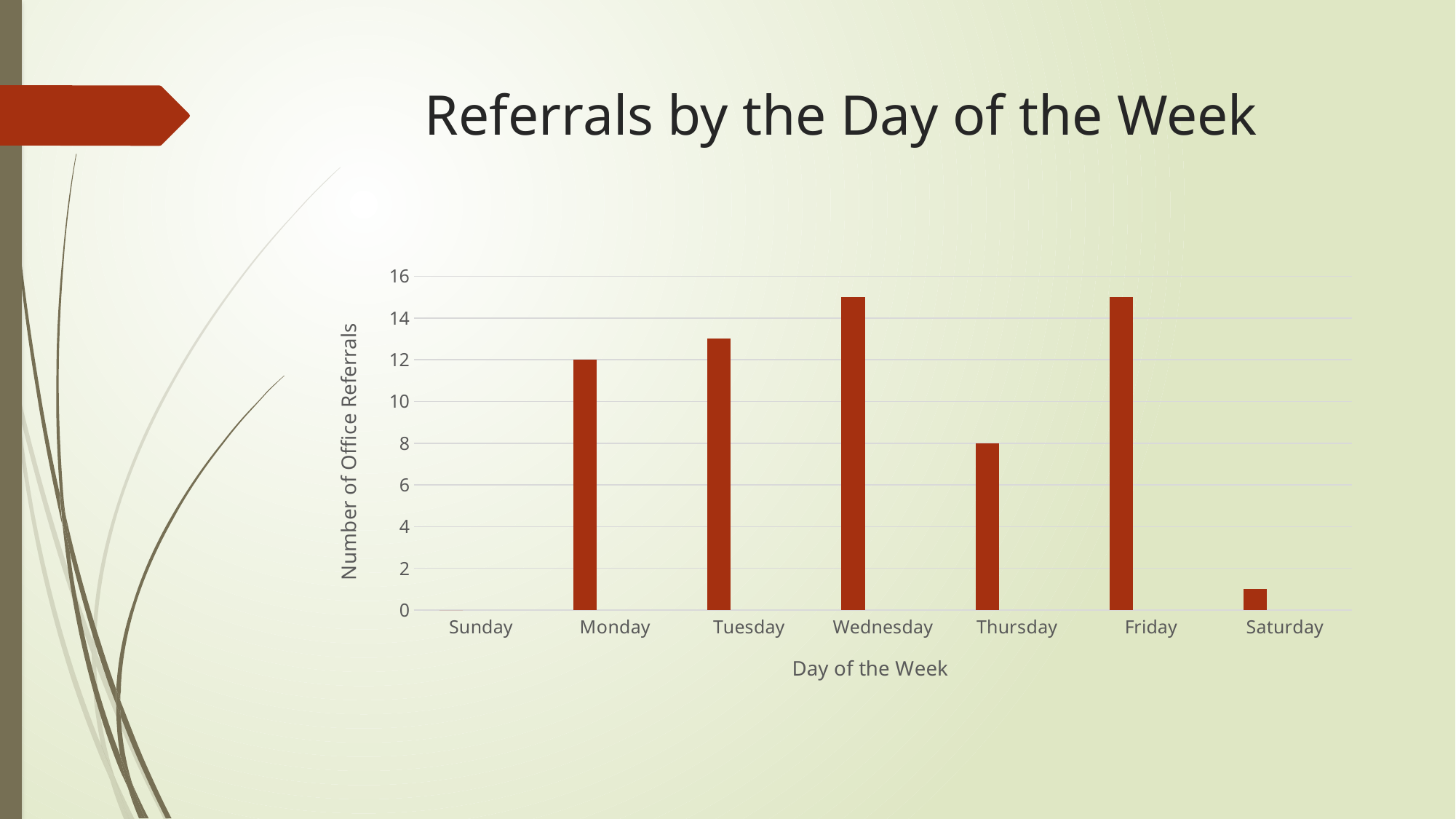
Which day of the week has the lowest number of office referrals? Sunday What is the difference between the number of referrals on Monday and on Thursday? 4 What is the title of the chart? Referrals by the Day of the Week How many office referrals were there on Sunday? 0 How many office referrals were there on Monday? 12 What is the label on the vertical axis of the chart? Number of Office Referrals Which day has more office referrals, Tuesday or Thursday? Tuesday Is the value for Wednesday greater or less than 14? greater Is the value for Saturday greater or less than 2? less What type of chart is shown on the slide? Bar chart How many days of the week are shown on the x axis? 7 How many office referrals were there on Thursday? 8